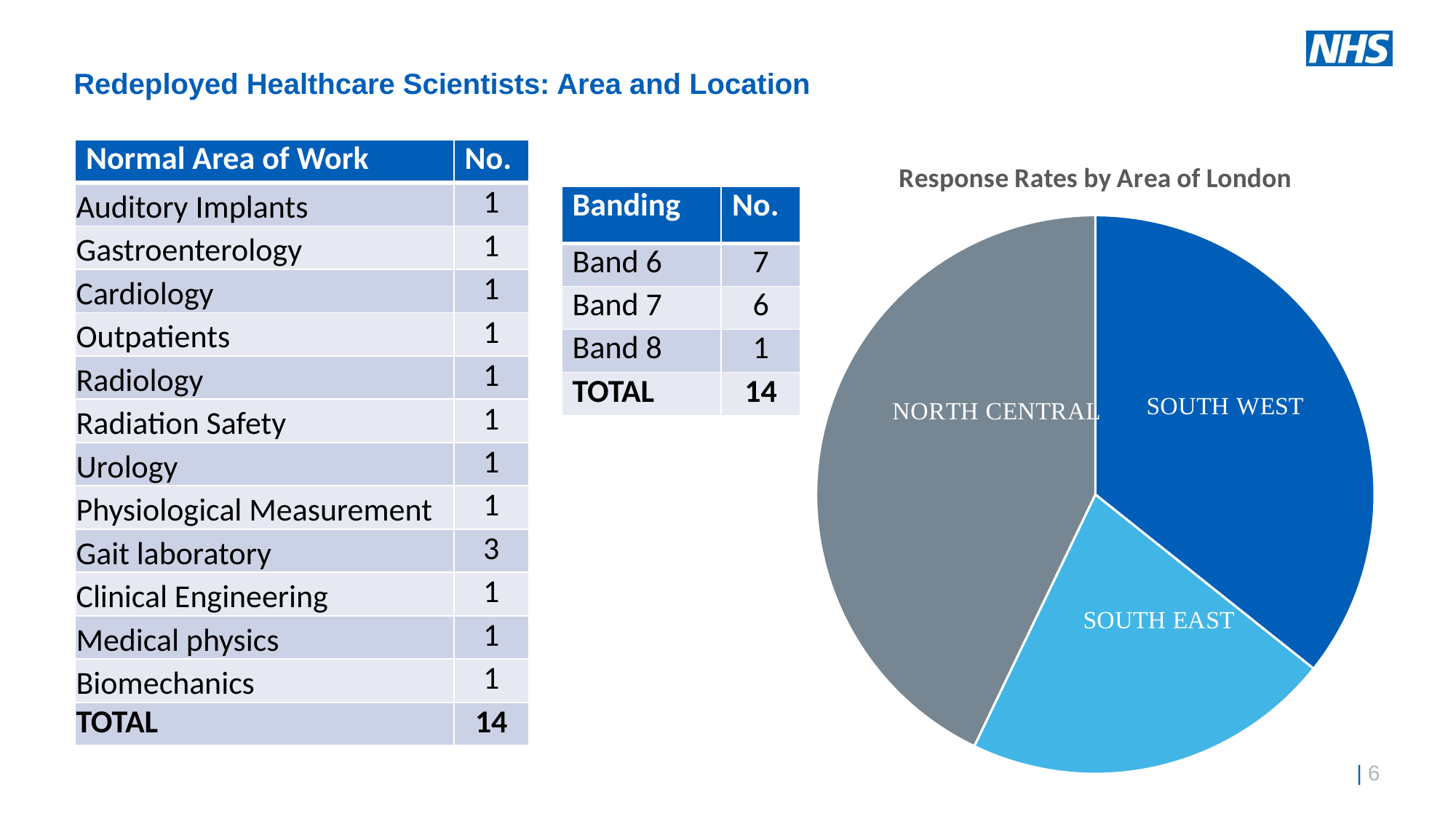
In the pie chart, which slice is larger: South West or South East? South West What is the title of the pie chart? Response Rates by Area of London What colour is the South East slice in the pie chart? light blue What kind of chart is shown on the slide? pie chart In the pie chart, which slice is larger: North Central or South East? North Central How many slices does the pie chart have? 3 Which area has the smallest slice in the pie chart? South East Which area has the largest slice in the pie chart? North Central